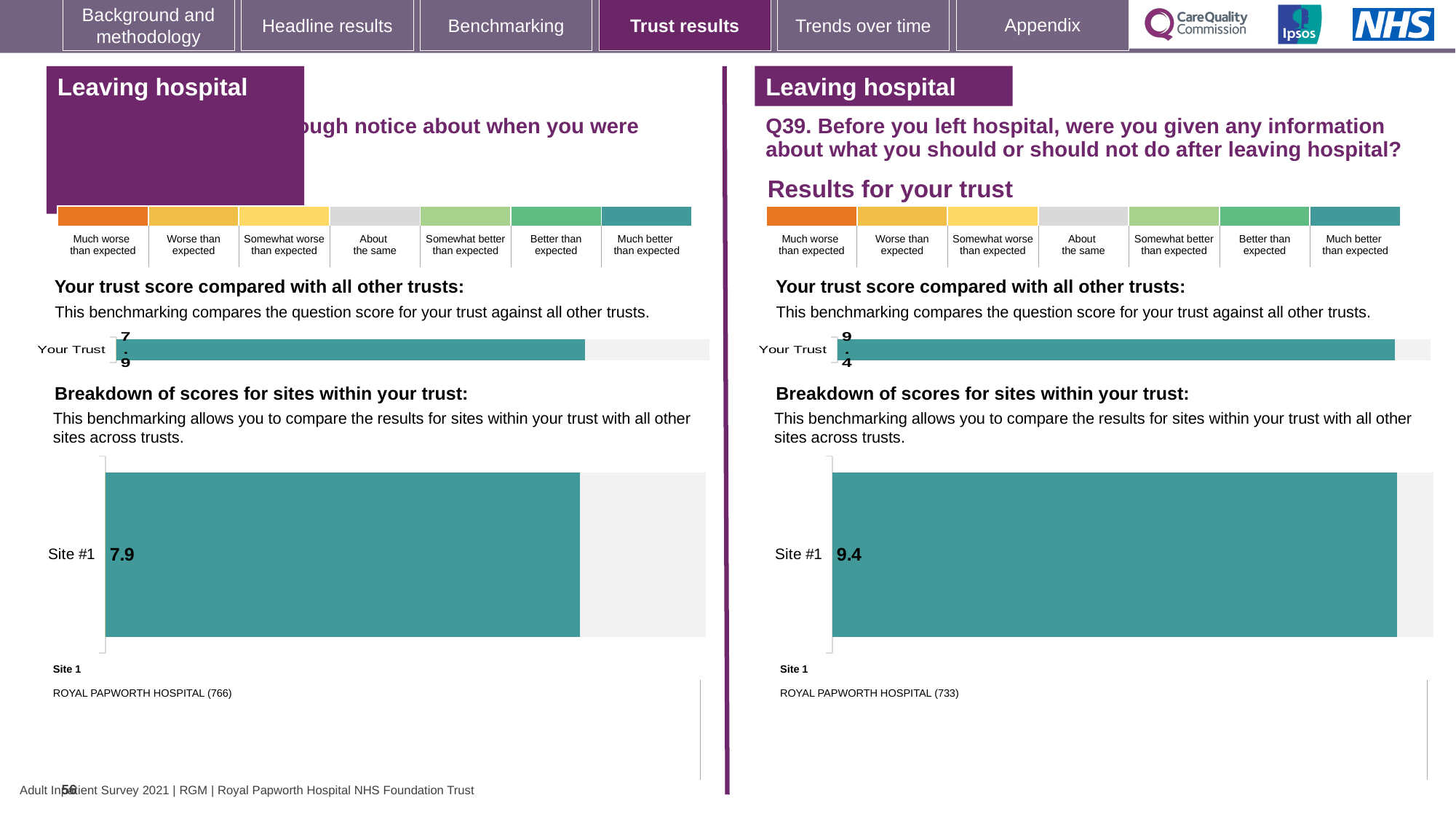
On the right-hand 'Breakdown of scores for sites within your trust' chart for Q39, what is the value for Site #1? 9.4 On the left-hand 'Your trust score compared with all other trusts' chart, what is the value for Your Trust? 7.9 What is the difference between the Site #1 score on the right-hand Q39 site breakdown chart and the Site #1 score on the left-hand site breakdown chart? 1.5 On the right-hand 'Your trust score compared with all other trusts' chart for Q39, what is the value for Your Trust? 9.4 On the left-hand 'Breakdown of scores for sites within your trust' chart, what is the value for Site #1? 7.9 How many sites are shown on the left-hand 'Breakdown of scores for sites within your trust' chart? 1 On the left-hand side, which site is listed as Site 1 below the site breakdown chart? ROYAL PAPWORTH HOSPITAL (766) On the right-hand side for Q39, which site is listed as Site 1 below the site breakdown chart? ROYAL PAPWORTH HOSPITAL (733) On the right-hand 'Your trust score compared with all other trusts' chart for Q39, what is the label of the single bar shown? Your Trust How many sites are shown on the right-hand 'Breakdown of scores for sites within your trust' chart for Q39? 1 Which is larger: the Site #1 score on the left-hand site breakdown chart or the Site #1 score on the right-hand site breakdown chart for Q39? The right-hand (Q39) chart What kind of chart is the 'Breakdown of scores for sites within your trust' chart on the right-hand side for Q39? Bar chart